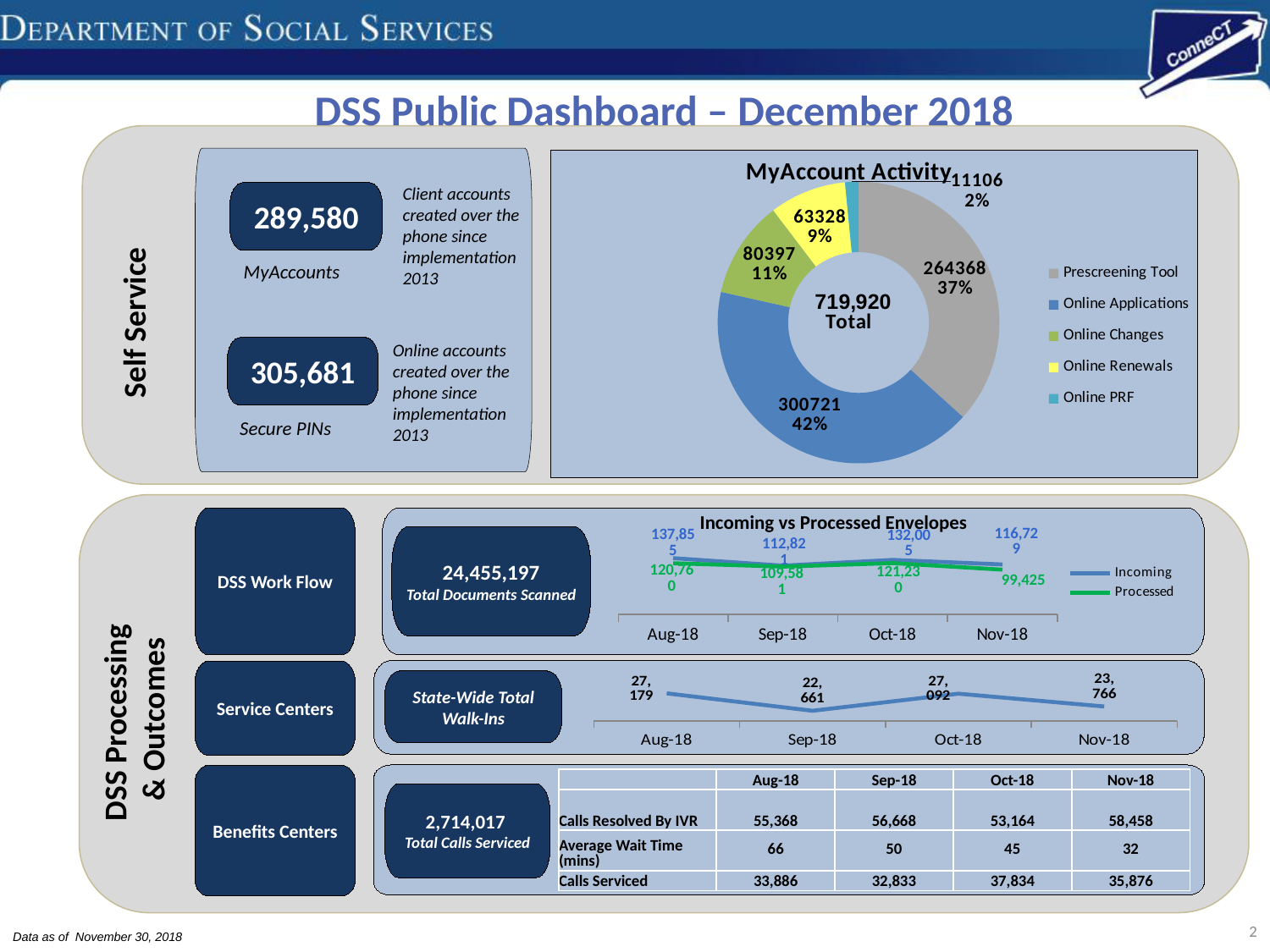
In the MyAccount Activity chart, which category has the smallest value? Online PRF How many categories does the legend of the MyAccount Activity chart list? 5 In the MyAccount Activity chart, what value is shown for Online Applications? 300721 In the Incoming vs Processed Envelopes chart, which month has the lowest Processed value? Nov-18 In the MyAccount Activity chart, what is the difference between the Online Changes value and the Online Renewals value? 17069 In the Incoming vs Processed Envelopes chart, what is the Incoming value for Aug-18? 137,855 In the MyAccount Activity chart, what percentage share does the Prescreening Tool have? 37% In the MyAccount Activity chart, which category has the largest value? Online Applications What type of chart is the MyAccount Activity chart? Donut (pie) chart In the State-Wide Total Walk-Ins chart, which is larger, the value for Aug-18 or the value for Nov-18? Aug-18 In the Incoming vs Processed Envelopes chart, what is the Processed value for Nov-18? 99,425 In the State-Wide Total Walk-Ins chart, what is the value for Sep-18? 22,661